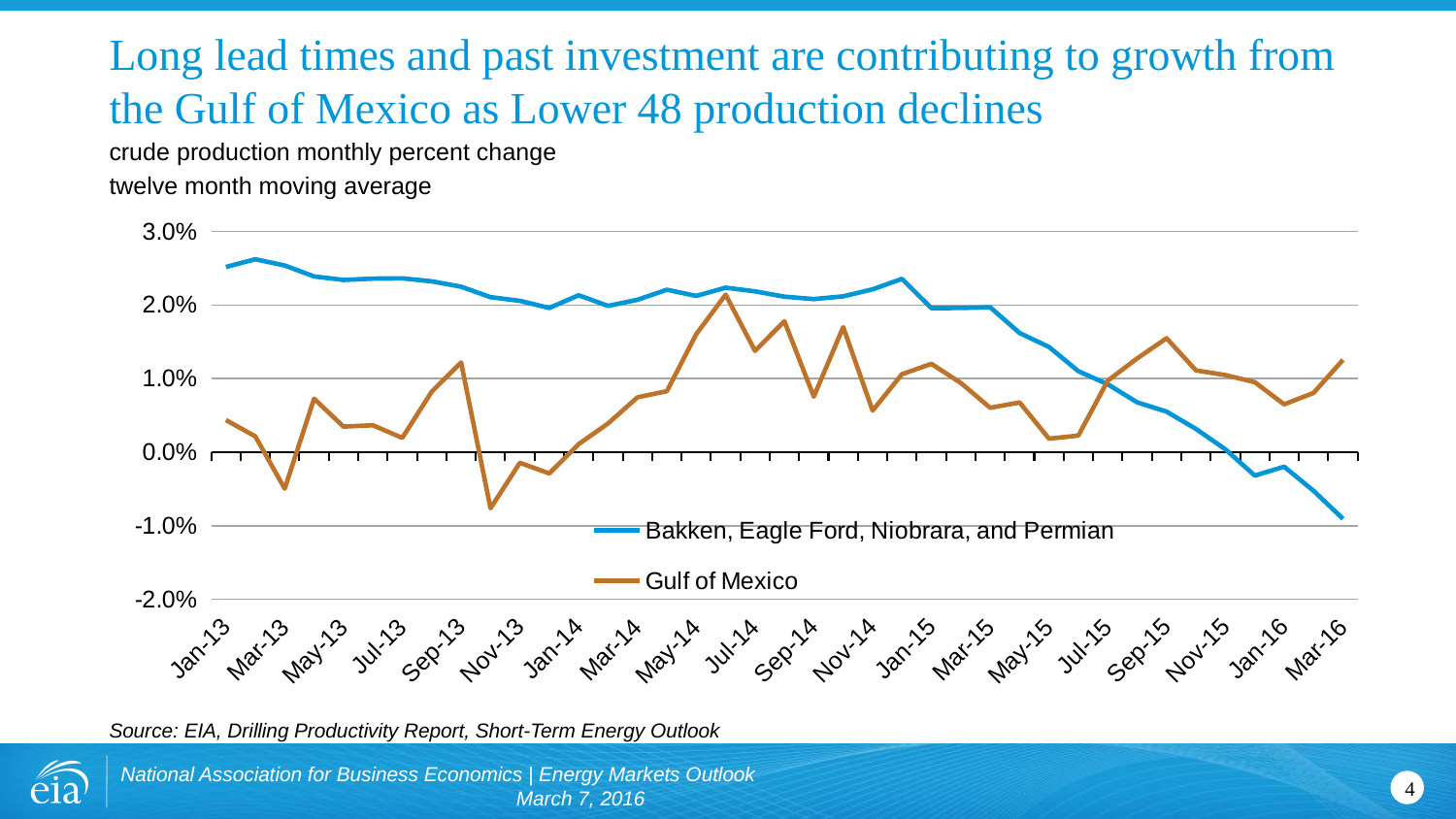
At Mar-16, which series has the higher value: Bakken, Eagle Ford, Niobrara, and Permian or Gulf of Mexico? Gulf of Mexico Is the value for Gulf of Mexico at Nov-13 greater or less than 0.0%? less What are the two series named in the legend? Bakken, Eagle Ford, Niobrara, and Permian; Gulf of Mexico Is the value for Bakken, Eagle Ford, Niobrara, and Permian at Mar-16 greater or less than 0.0%? less Is the value for Bakken, Eagle Ford, Niobrara, and Permian at Jan-13 greater or less than 2.0%? greater Overall, does the Bakken, Eagle Ford, Niobrara, and Permian line rise or fall from Jan-13 to Mar-16? fall What is the highest value shown on the y axis? 3.0% How many month labels are shown along the x axis? 20 What kind of chart is shown on the slide? line chart At Jan-13, which series has the higher value: Bakken, Eagle Ford, Niobrara, and Permian or Gulf of Mexico? Bakken, Eagle Ford, Niobrara, and Permian How many series does the legend list? 2